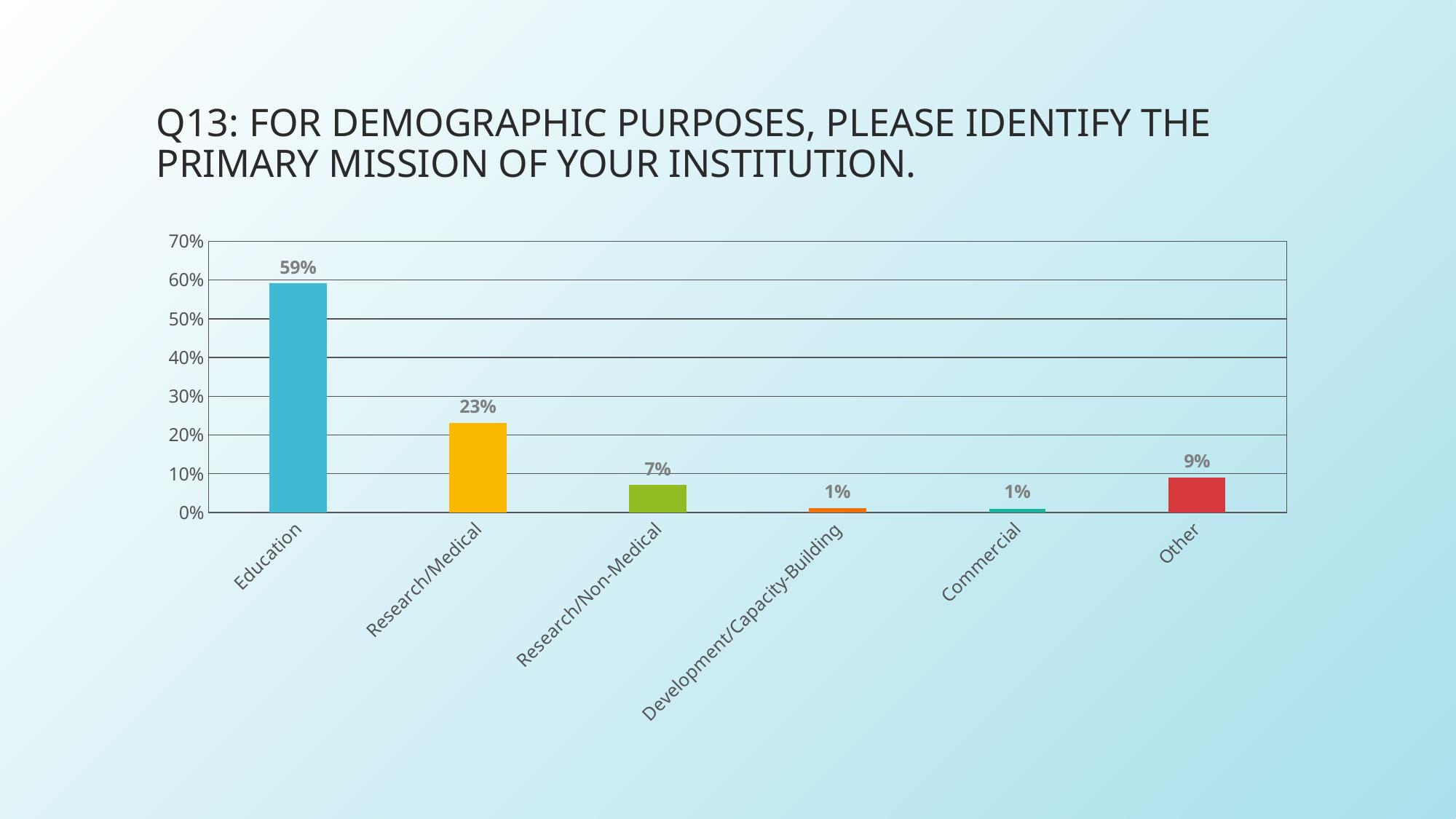
What is the maximum value shown on the y axis? 70% Is the value for Education greater or less than 50%? greater How many categories are shown on the x axis? 6 What percentage of respondents identified Education as the primary mission of their institution? 59% Which is larger, the value for Research/Non-Medical or the value for Other? Other What is the value shown for Research/Medical? 23% Which category has the highest value? Education What is the difference between the values for Education and Research/Medical? 36% What is the difference between the values for Other and Research/Non-Medical? 2% What is the value shown for Research/Non-Medical? 7% What is the value shown for Other? 9% What kind of chart is shown on the slide? Bar chart